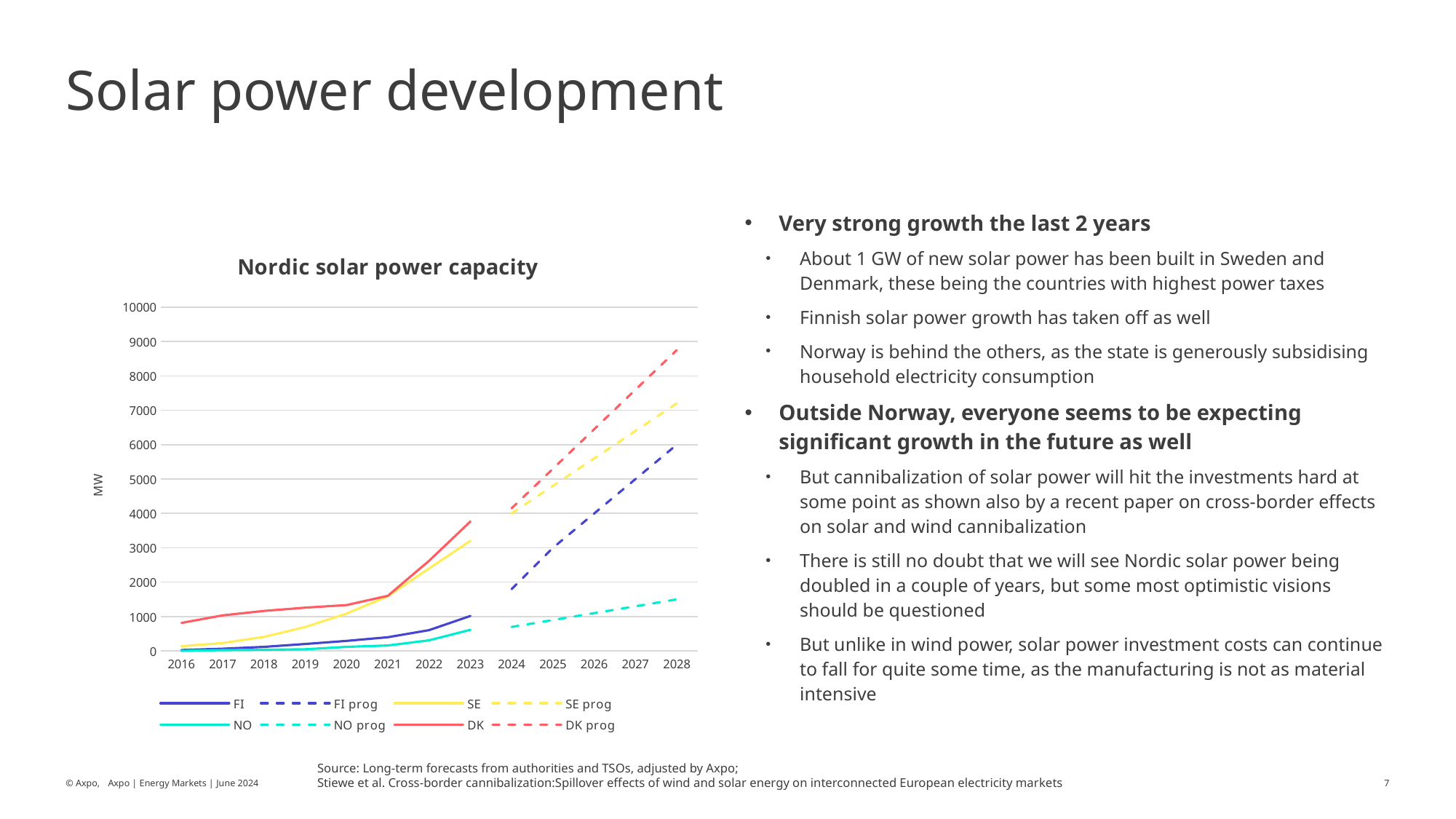
Is the value for SE prog in 2028 greater or less than 6000? greater What unit is shown on the y axis of the chart? MW In 2023, which is larger, the value for DK or the value for SE? DK Which series has the highest value in 2028? DK prog Is the value for NO prog in 2028 greater or less than 2000? less Is the value for DK prog in 2028 greater or less than 8000? greater Which series has the lowest value in 2028? NO prog How many years are shown on the x axis of the chart? 13 How many series does the chart legend list? 8 What is the title of the chart? Nordic solar power capacity What kind of chart is shown on the slide? line chart